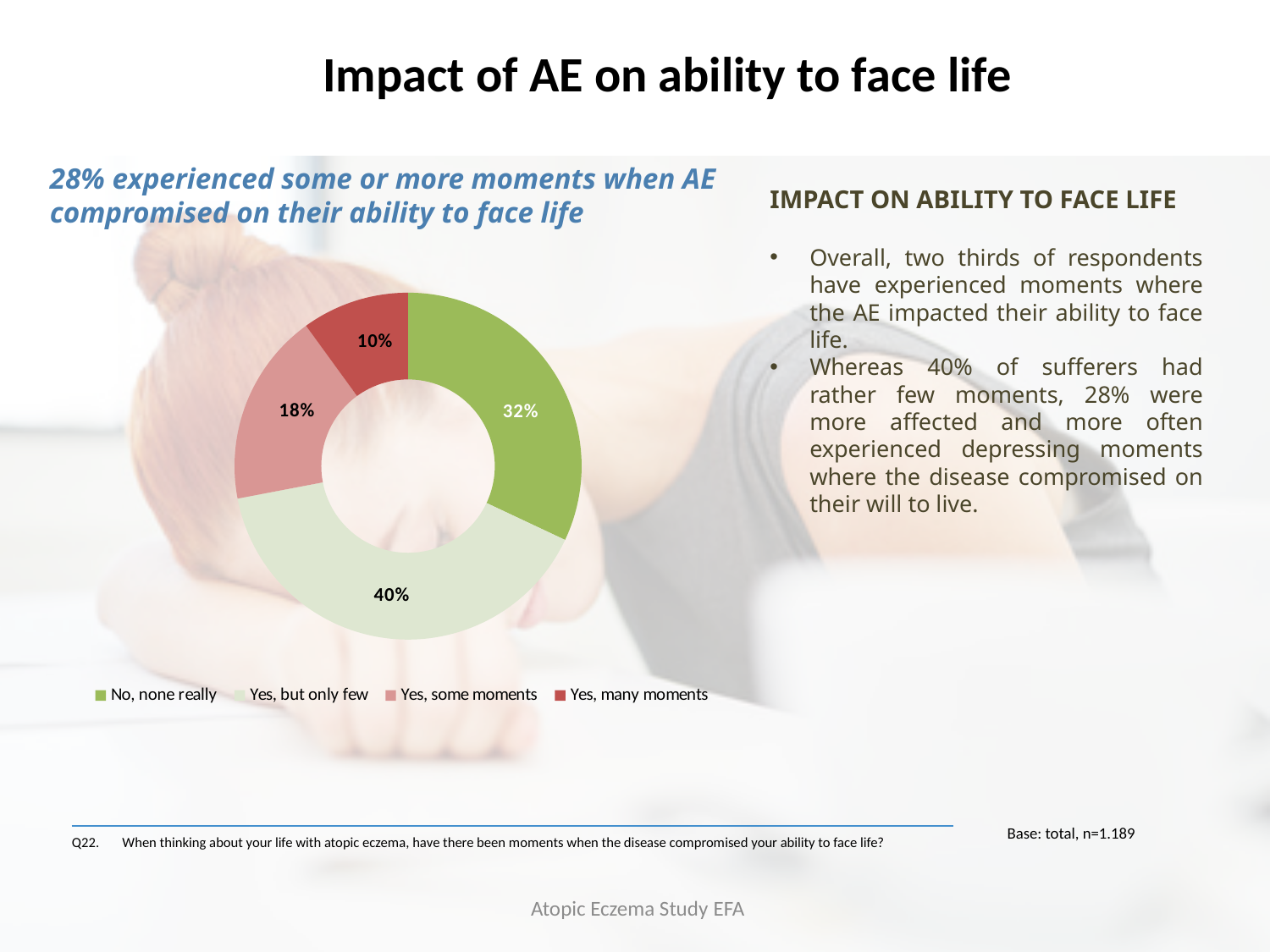
What percentage of respondents answered "Yes, but only few"? 40% What colour is the slice for "Yes, many moments"? Red Which response category has the largest share of the chart? Yes, but only few What percentage of respondents answered "Yes, some moments"? 18% What is the difference in percentage points between "Yes, some moments" and "Yes, many moments"? 8 Which is larger: the share for "No, none really" or the share for "Yes, some moments"? No, none really What is the difference in percentage points between "Yes, but only few" and "No, none really"? 8 What percentage of respondents answered "No, none really"? 32% Which response category has the smallest share of the chart? Yes, many moments What percentage of respondents answered "Yes, many moments"? 10% What kind of chart is shown on the slide? Donut (pie) chart How many response categories are shown in the chart? 4